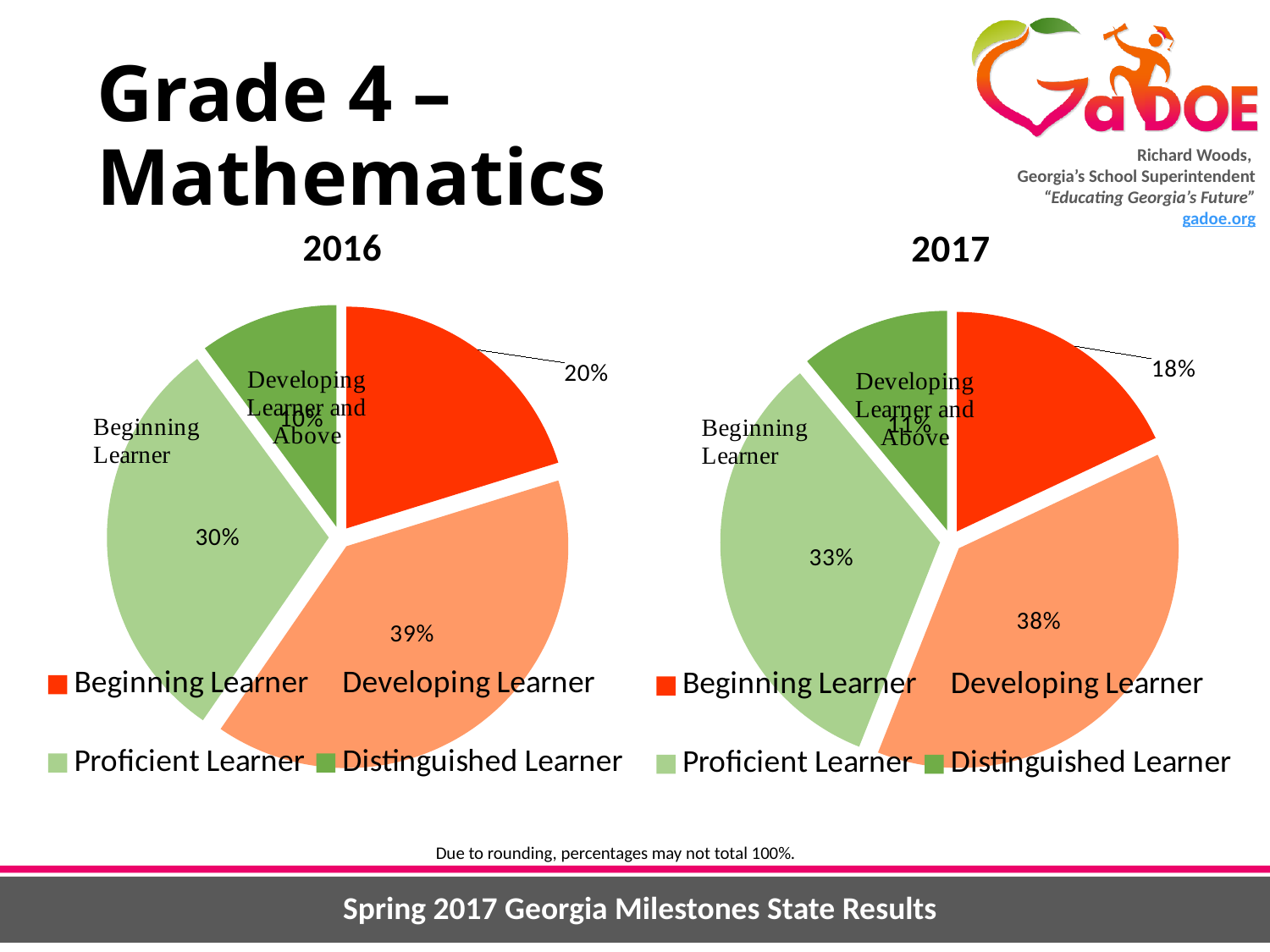
What is the difference between the Beginning Learner percentage in 2016 and in 2017? 2% In the 2016 pie chart, what percentage is shown for Beginning Learner? 20% In the 2017 pie chart, which category has the largest slice? Developing Learner How many slices does the 2016 pie chart have? 4 In the 2017 pie chart, what percentage is shown for Proficient Learner? 33% What type of chart is used to show the 2017 results? Pie chart In the 2017 pie chart, what percentage is shown for Distinguished Learner? 11% In the 2016 pie chart, which category has the smallest slice? Distinguished Learner In the 2016 pie chart, what percentage is shown for Developing Learner? 39% How many entries does the legend of the 2017 chart list? 4 In the 2016 pie chart, what is the combined percentage of Proficient Learner and Distinguished Learner? 40% Is the Proficient Learner share larger in the 2016 chart or the 2017 chart? 2017